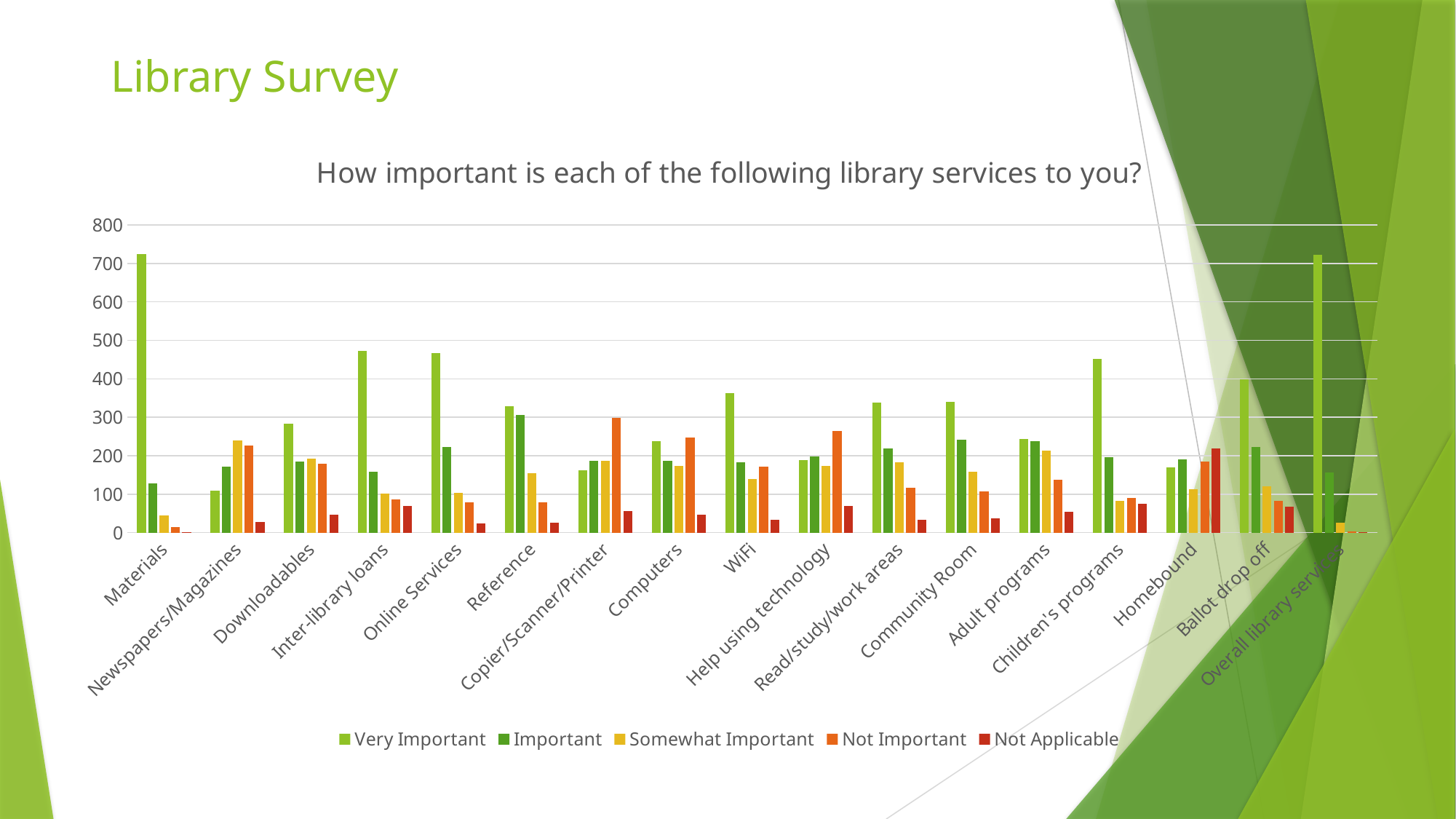
Which category has the lowest Very Important value? Newspapers/Magazines For Copier/Scanner/Printer, which is larger, the Very Important value or the Not Important value? Not Important Which has the larger Very Important value, Inter-library loans or Reference? Inter-library loans Is the Very Important value for WiFi greater or less than 300? greater What is the title of the chart? How important is each of the following library services to you? Is the Very Important value for Materials greater or less than 700? greater Is the Very Important value for Homebound greater or less than 200? less How many series does the legend list? 5 How many library service categories are shown on the x axis? 17 What kind of chart is shown on the slide? bar chart